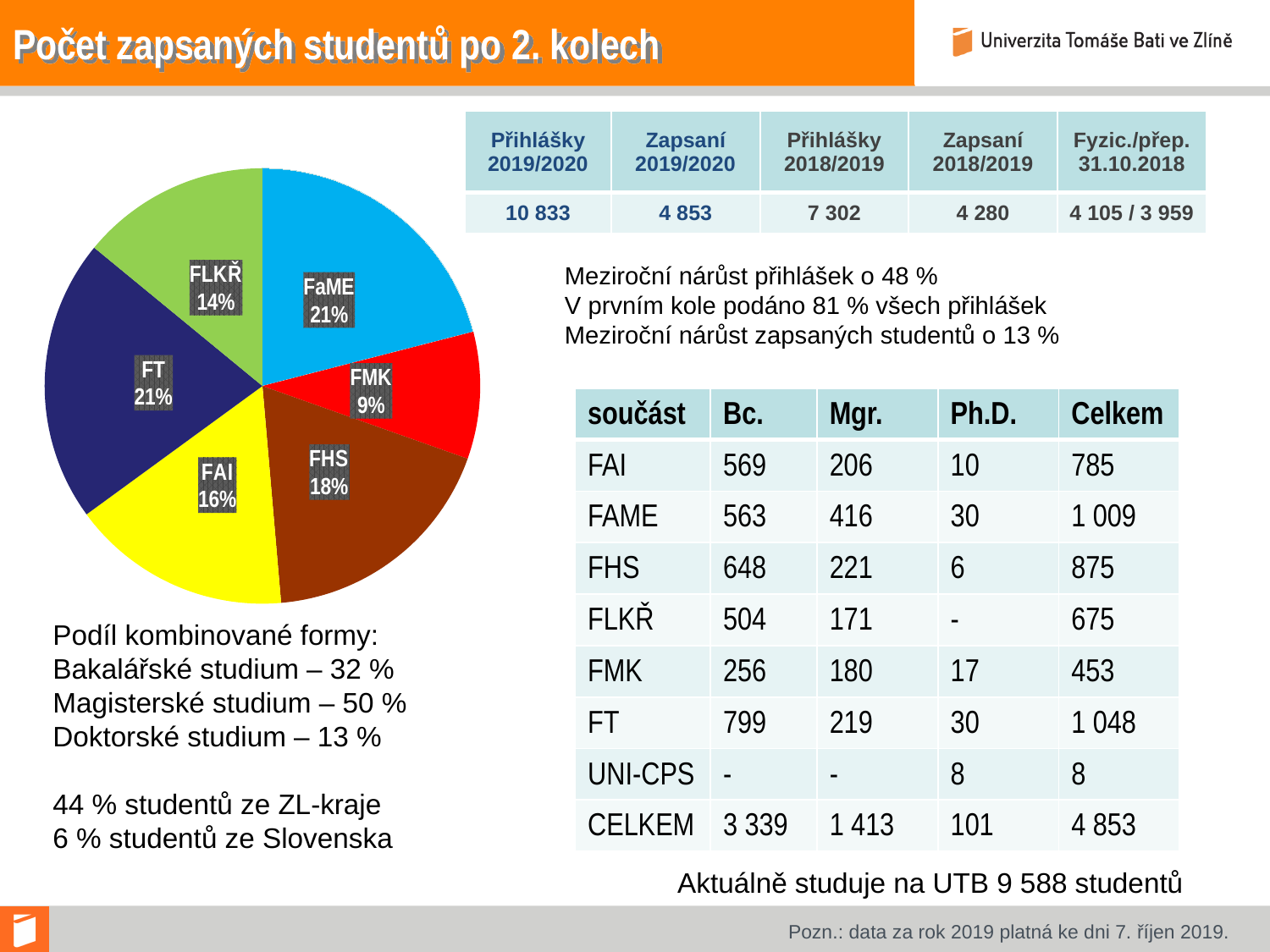
What percentage is shown for FLKŘ in the pie chart? 14% What share of the pie chart does FHS have? 18% What kind of chart is shown on the slide? pie chart In the pie chart, which is larger, FLKŘ or FMK? FLKŘ In the pie chart, which is larger, FHS or FAI? FHS Which slice of the pie chart is the smallest? FMK What percentage is shown for FT in the pie chart? 21% What percentage is shown for FAI in the pie chart? 16% What is the difference in percentage points between FHS and FAI in the pie chart? 2 What is the difference in percentage points between FaME and FMK in the pie chart? 12 What colour is the FMK slice in the pie chart? red How many slices does the pie chart have? 6